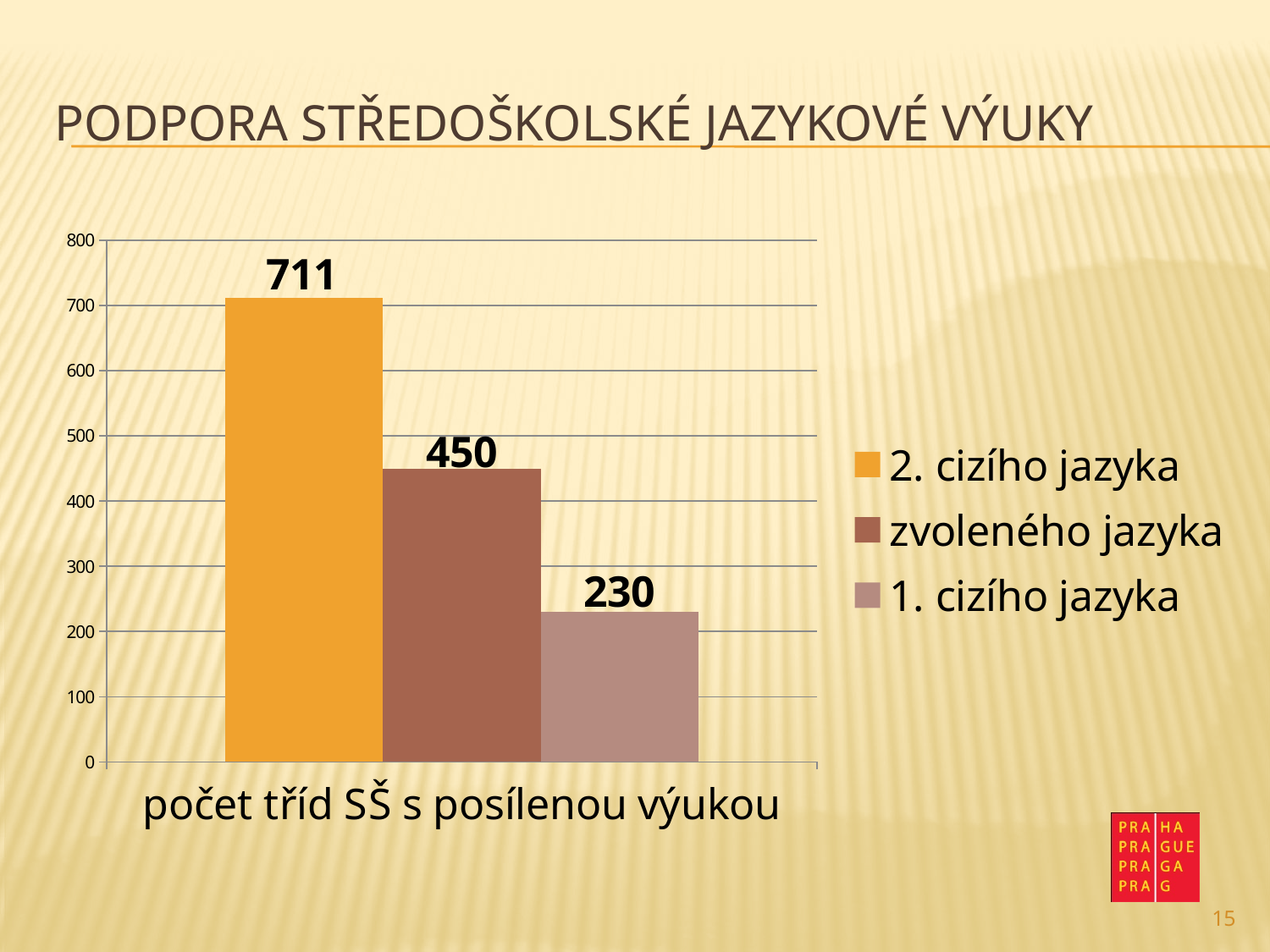
Which series has the lowest value? 1. cizího jazyka Is the value for "2. cizího jazyka" greater or less than 700? greater What kind of chart is shown on the slide? bar chart How many series does the legend list? 3 What is the value for "1. cizího jazyka"? 230 What is the value for "2. cizího jazyka"? 711 What is the difference between the values for "2. cizího jazyka" and "zvoleného jazyka"? 261 What is the value for "zvoleného jazyka"? 450 Which series has the highest value? 2. cizího jazyka What is the difference between the values for "zvoleného jazyka" and "1. cizího jazyka"? 220 What is the category label shown below the bars? počet tříd SŠ s posílenou výukou Which is larger, the value for "zvoleného jazyka" or the value for "1. cizího jazyka"? zvoleného jazyka